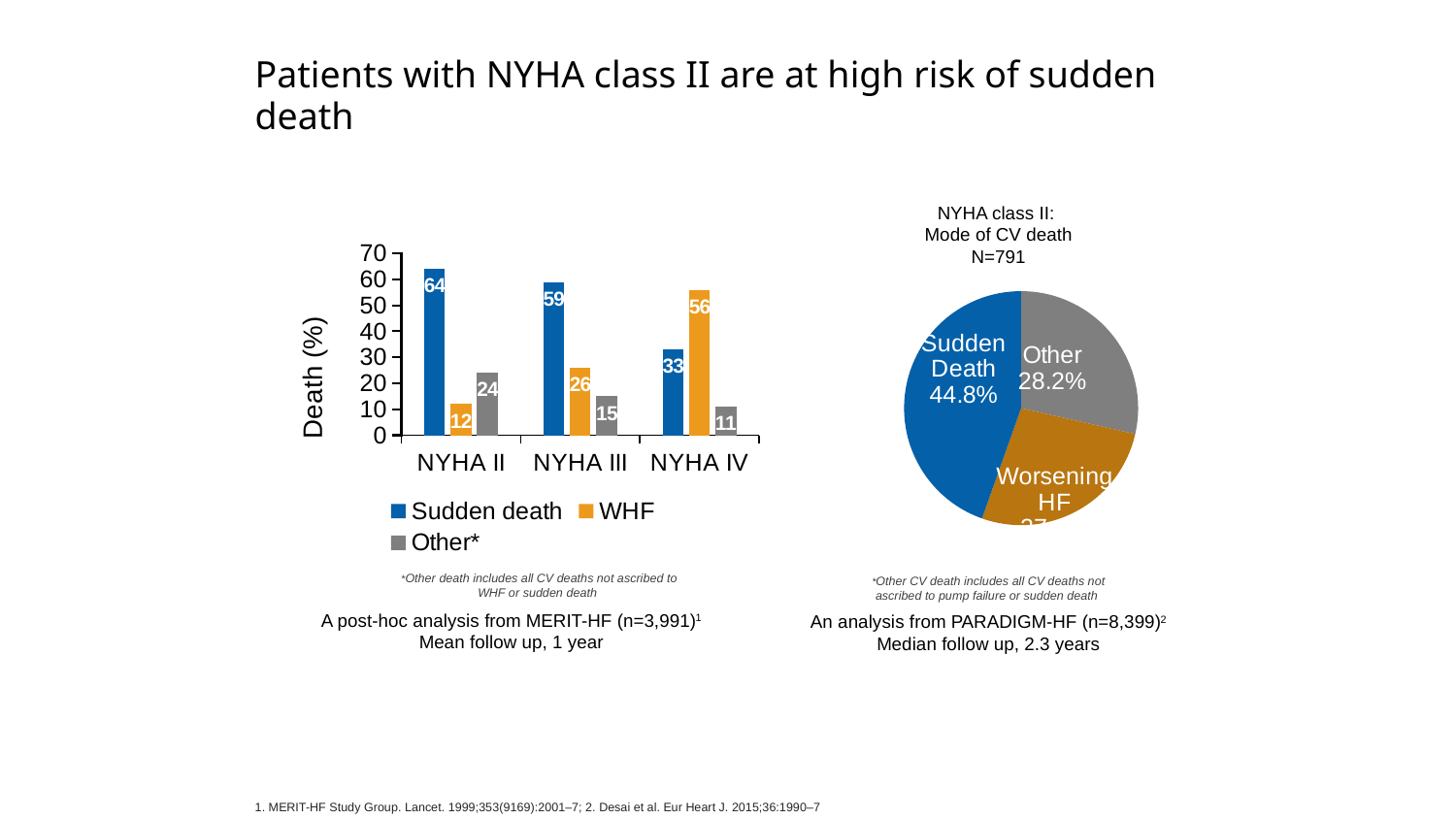
What type of chart is shown on the right side of the slide? Pie chart In the bar chart on the left, what is the WHF value for NYHA IV? 56 In the bar chart on the left, how many series does the legend list? 3 In the bar chart on the left, what is the Sudden death value for NYHA II? 64 In the bar chart on the left, how does the Sudden death value change from NYHA II to NYHA IV? It falls In the bar chart on the left, which NYHA class has the lowest WHF value? NYHA II In the pie chart titled 'NYHA class II: Mode of CV death', what share is Sudden Death? 44.8% In the bar chart on the left, which NYHA class has the highest Sudden death value? NYHA II In the bar chart on the left, what is the difference between the Sudden death values for NYHA II and NYHA IV? 31 In the pie chart titled 'NYHA class II: Mode of CV death', what share is Other? 28.2% In the bar chart on the left, which is larger for NYHA III: Sudden death or WHF? Sudden death In the bar chart on the left, what is the Other* value for NYHA III? 15